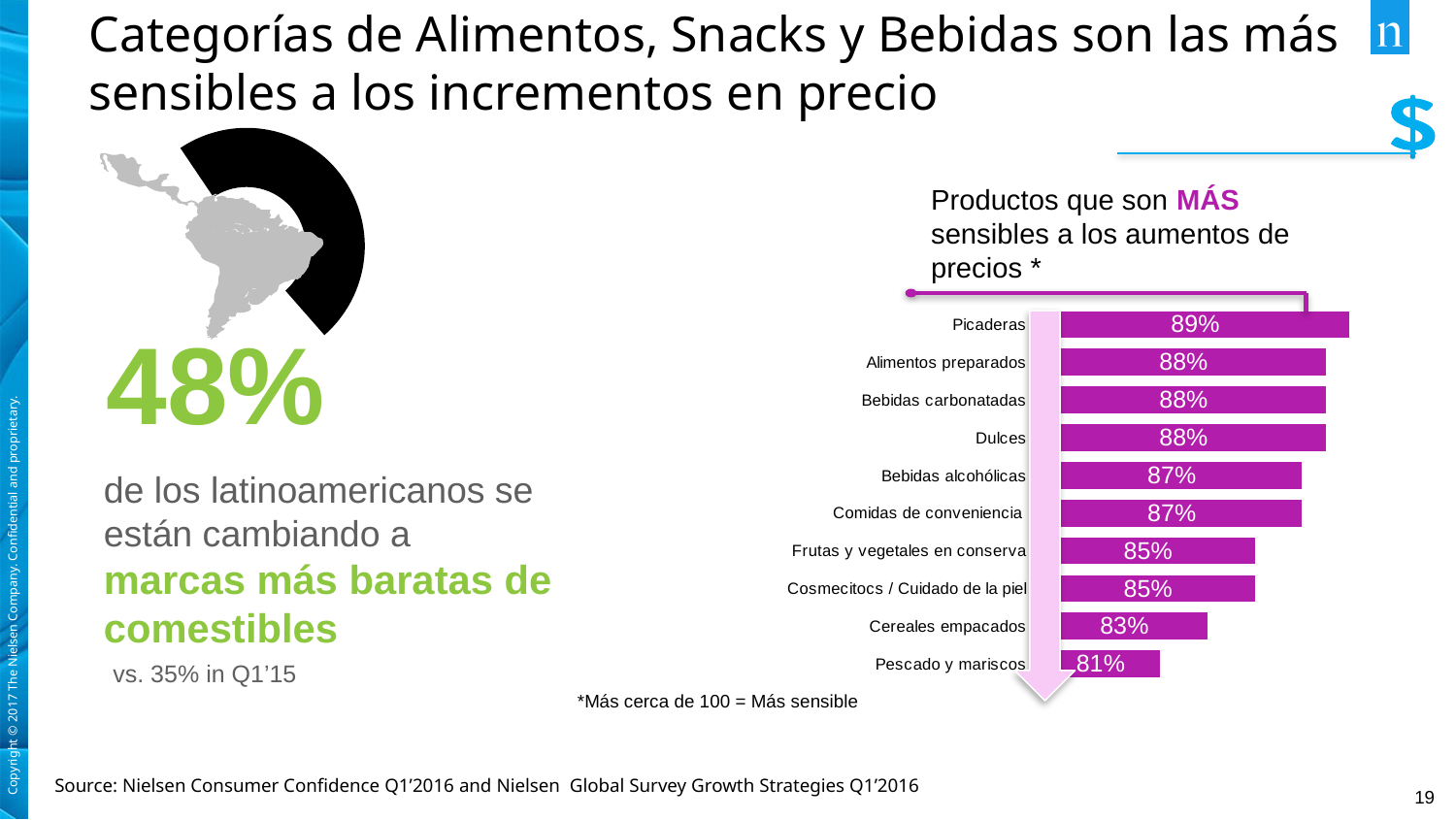
In the bar chart of products most sensitive to price increases, what is the value for Picaderas? 89% In the bar chart of products most sensitive to price increases, which category has the lowest value? Pescado y mariscos In the bar chart of products most sensitive to price increases, which is larger: Comidas de conveniencia or Frutas y vegetales en conserva? Comidas de conveniencia In the bar chart of products most sensitive to price increases, which category has the highest value? Picaderas In the bar chart of products most sensitive to price increases, how many categories have a value of 88%? 3 What kind of chart is used to show the products most sensitive to price increases? Bar chart In the bar chart of products most sensitive to price increases, what is the difference between Picaderas and Pescado y mariscos? 8% In the bar chart of products most sensitive to price increases, what is the value for Pescado y mariscos? 81% How many categories are shown in the bar chart of products most sensitive to price increases? 10 In the bar chart of products most sensitive to price increases, what is the difference between Dulces and Cereales empacados? 5% In the bar chart of products most sensitive to price increases, what is the value for Bebidas alcohólicas? 87% In the bar chart of products most sensitive to price increases, what is the value for Cereales empacados? 83%